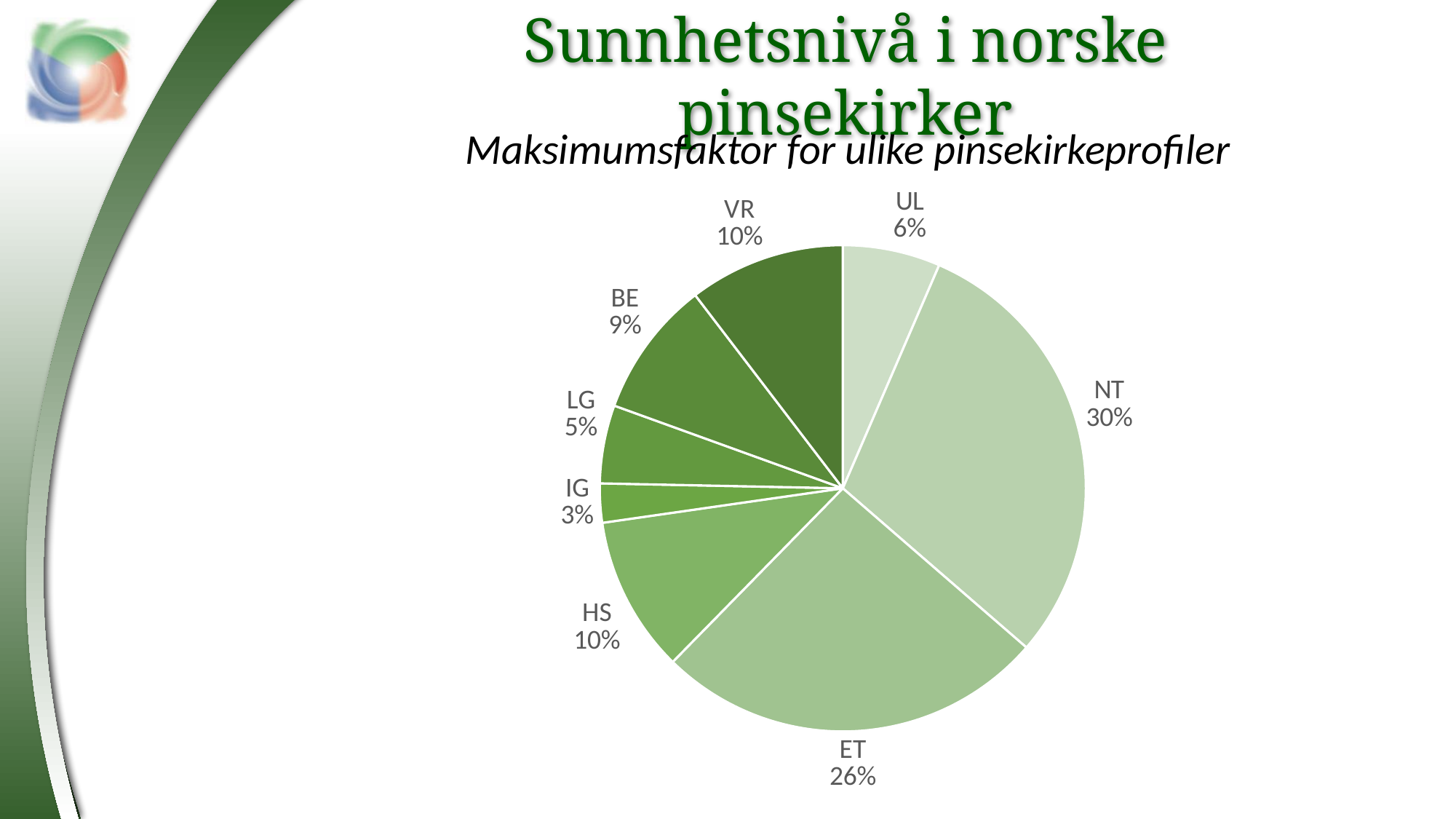
What share of the pie does ET have? 26% What type of chart is shown on the slide? pie chart What is the value for BE? 9% Which is larger, the share for UL or the share for LG? UL What is the title of the chart? Maksimumsfaktor for ulike pinsekirkeprofiler Which category has the largest slice? NT What is the combined share of VR and HS? 20% Which category has the smallest slice? IG What share of the pie does NT have? 30% What is the difference between the shares of NT and ET? 4% What is the value for IG? 3% How many slices does the pie chart have? 8